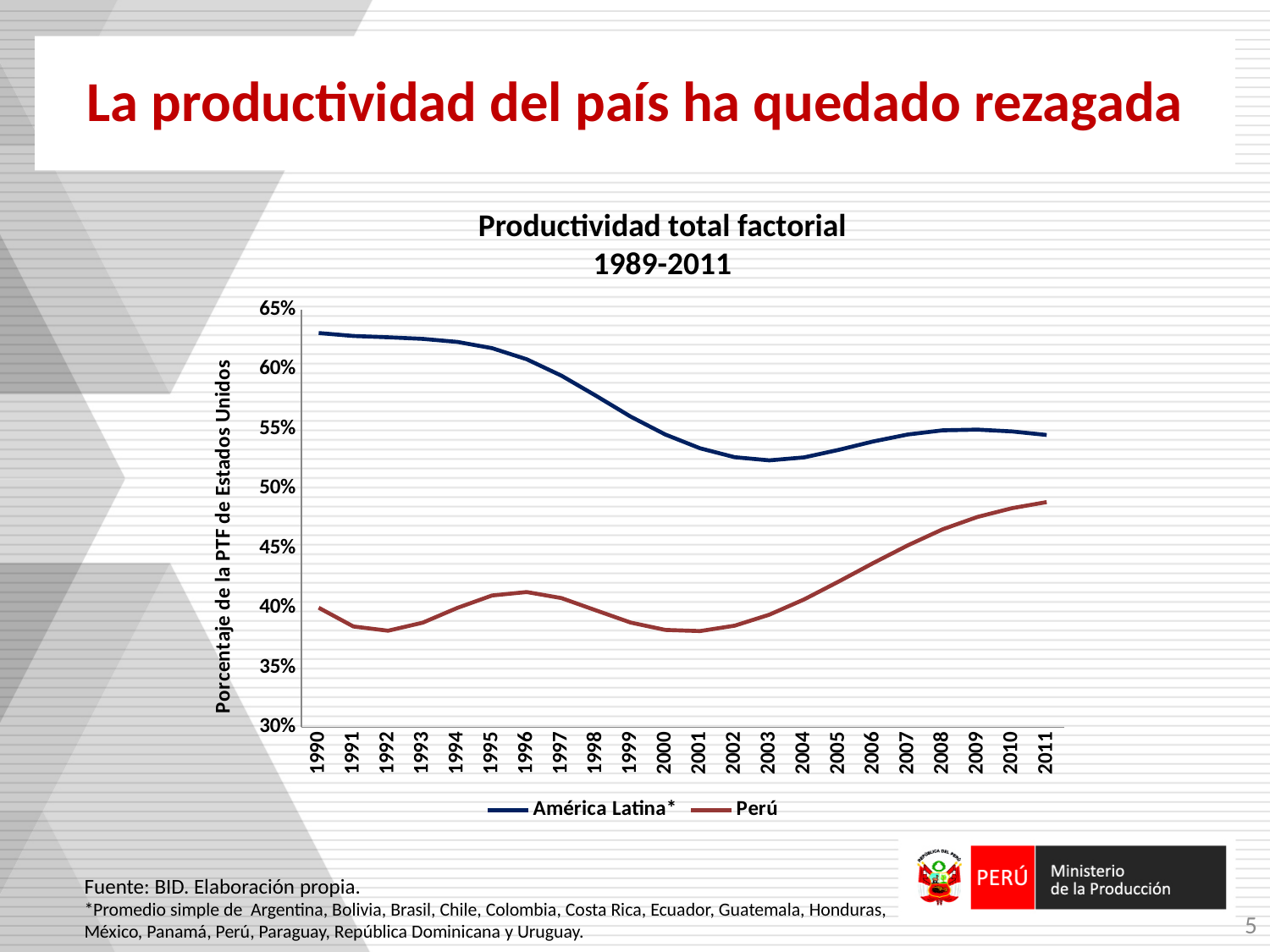
Which two series are shown in the legend? América Latina* and Perú How many years are labelled on the x axis? 22 Is the value for Perú in 2011 greater or less than 50%? less In 2000, which series has the higher value, América Latina* or Perú? América Latina* In which year does the Perú series reach its highest value? 2011 Is the value for Perú in 2001 greater or less than 40%? less What is the title of the chart? Productividad total factorial 1989-2011 Is the value for América Latina* in 2003 greater or less than 50%? greater Does the Perú series rise or fall between 2003 and 2011? rise What kind of chart is shown on the slide? line chart How many series does the legend list? 2